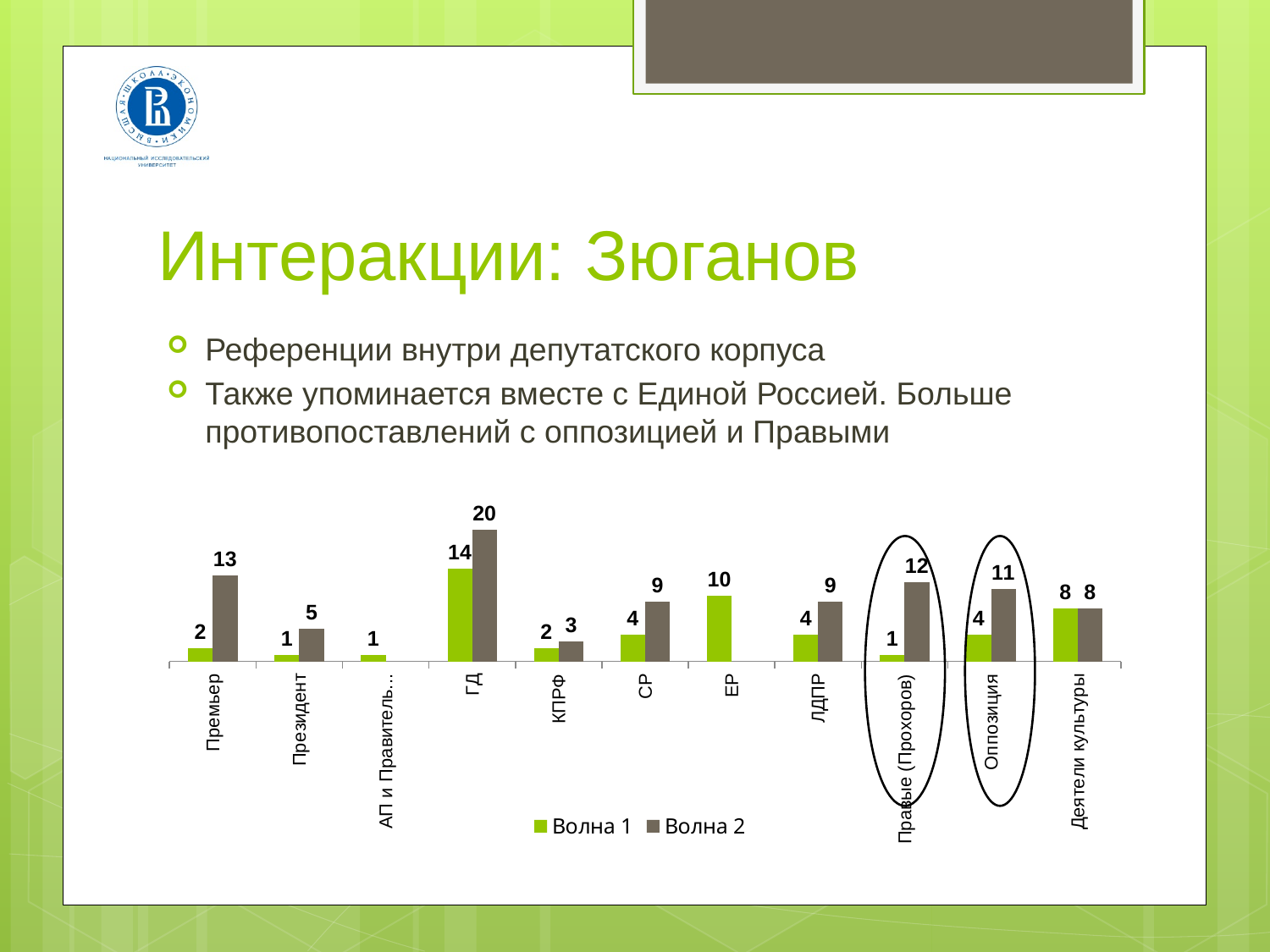
Which category has the highest value in the Волна 2 series? ГД What is the value for ГД in the Волна 2 series? 20 What is the value for ЕР in the Волна 1 series? 10 Which is larger for Правые (Прохоров): the Волна 1 value or the Волна 2 value? Волна 2 How many categories are shown on the x axis? 11 Which category has equal values for Волна 1 and Волна 2? Деятели культуры What is the value for Премьер in the Волна 1 series? 2 Which category has the highest value in the Волна 1 series? ГД How many series does the legend list? 2 What is the difference between the Волна 2 and Волна 1 values for Премьер? 11 What kind of chart is shown on the slide? Bar chart What is the value for Оппозиция in the Волна 2 series? 11